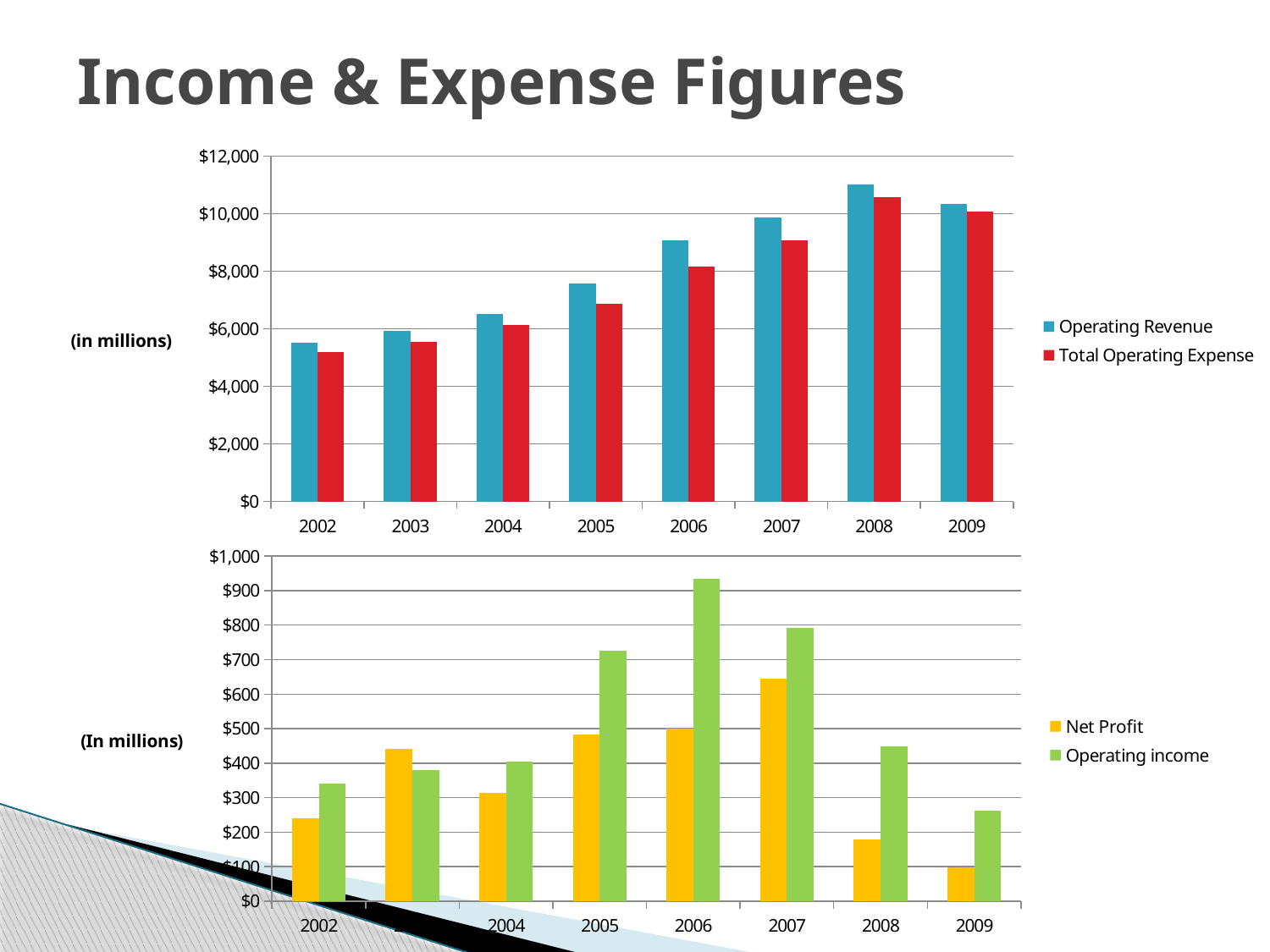
How many years are shown on the x axis of the top chart? 8 In the bottom chart, which is larger for 2003: Net Profit or Operating income? Net Profit In the top chart, does Operating Revenue rise or fall from 2002 to 2008? rise In the bottom chart, which year has the lowest Net Profit? 2009 In the bottom chart, which year has the highest Operating income? 2006 In the top chart, which year has the lowest Total Operating Expense? 2002 In the top chart, is the Total Operating Expense for 2005 greater or less than $8,000? less In the top chart, is the Operating Revenue for 2008 greater or less than $10,000? greater How many series does the legend of the top chart list? 2 In the top chart, which year has the highest Operating Revenue? 2008 What kind of chart is the top chart on the slide? bar chart In the bottom chart, is the Net Profit for 2008 greater or less than $200? less